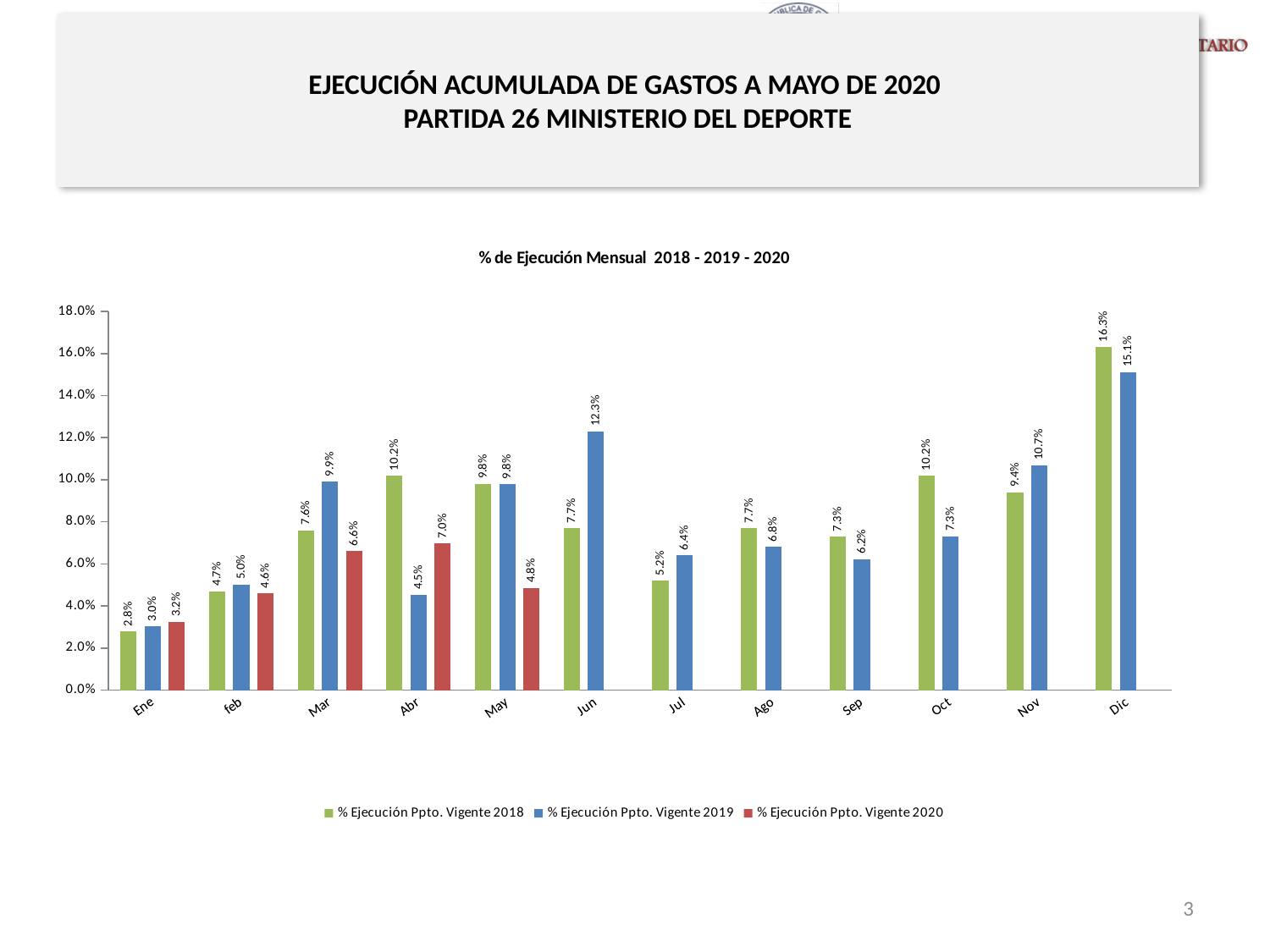
How many series does the legend list? 3 What is the % Ejecución Ppto. Vigente 2019 value for Jun? 12.3% What is the title of the chart? % de Ejecución Mensual 2018 - 2019 - 2020 What kind of chart is shown on the slide? Bar chart What is the difference between the 2018 and 2019 values for Abr? 5.7% Which month has the lowest % Ejecución Ppto. Vigente 2018 value? Ene How many months are shown on the x axis? 12 What is the % Ejecución Ppto. Vigente 2020 value for Abr? 7.0% Which month has the highest % Ejecución Ppto. Vigente 2019 value? Dic Is the % Ejecución Ppto. Vigente 2019 value for Nov greater or less than 10.0%? greater What is the % Ejecución Ppto. Vigente 2018 value for Dic? 16.3% Which is larger for Mar: the 2019 value or the 2020 value? 2019 value